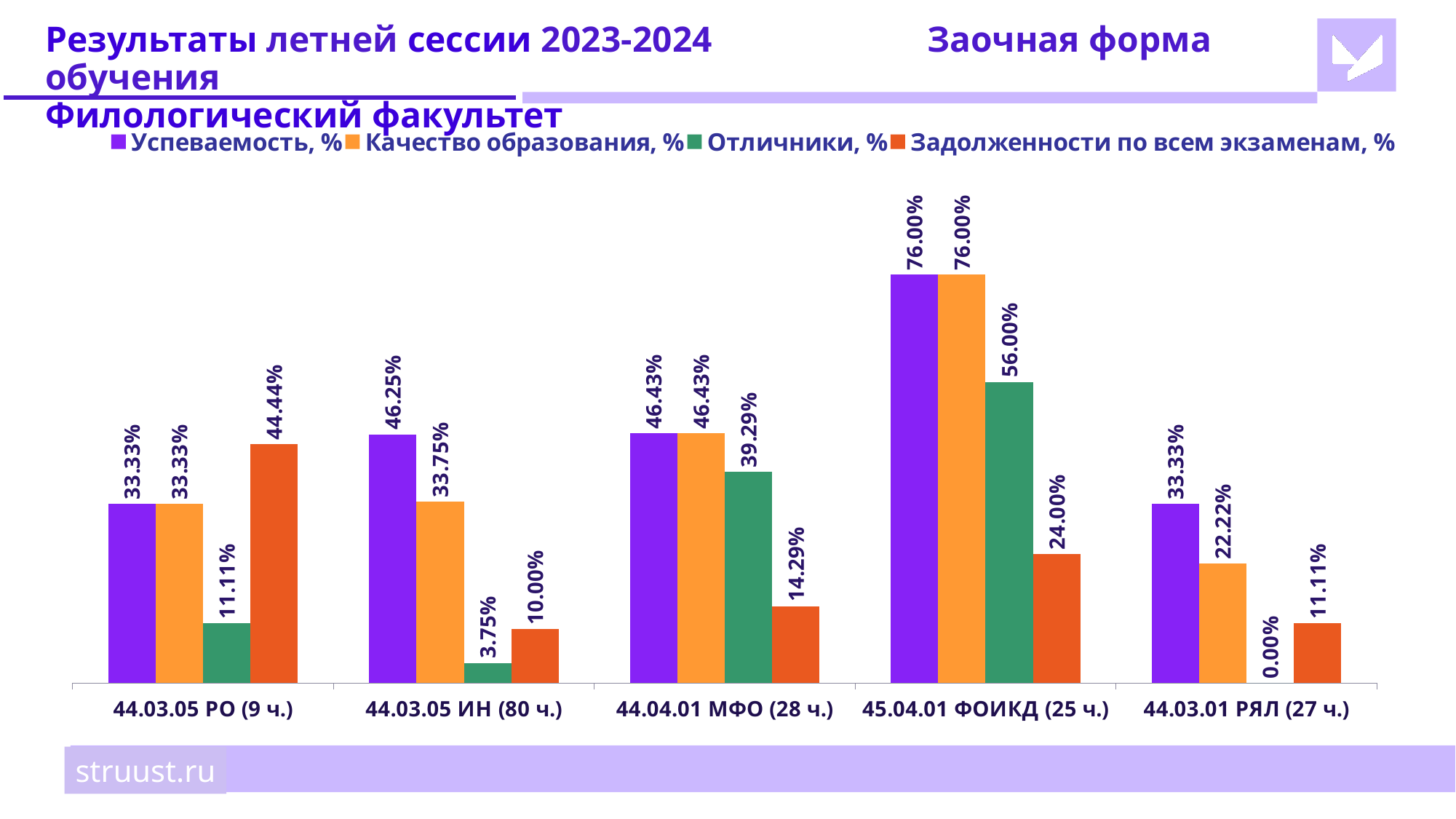
What is the value of Успеваемость, % for 45.04.01 ФОИКД (25 ч.)? 76.00% Which category has the highest value for Отличники, %? 45.04.01 ФОИКД (25 ч.) What is the value of Задолженности по всем экзаменам, % for 44.03.05 РО (9 ч.)? 44.44% Which series is shown in orange in the legend? Качество образования, % What is the value of Отличники, % for 44.03.05 ИН (80 ч.)? 3.75% How many categories (programmes) are shown on the x axis? 5 How many series does the legend list? 4 What type of chart is shown on the slide? bar chart What is the value of Качество образования, % for 44.03.01 РЯЛ (27 ч.)? 22.22% Which is larger for 44.04.01 МФО (28 ч.): Отличники, % or Задолженности по всем экзаменам, %? Отличники, % What is the difference between Успеваемость, % and Качество образования, % for 44.03.05 ИН (80 ч.)? 12.50% Which category has the lowest value for Задолженности по всем экзаменам, %? 44.03.05 ИН (80 ч.)